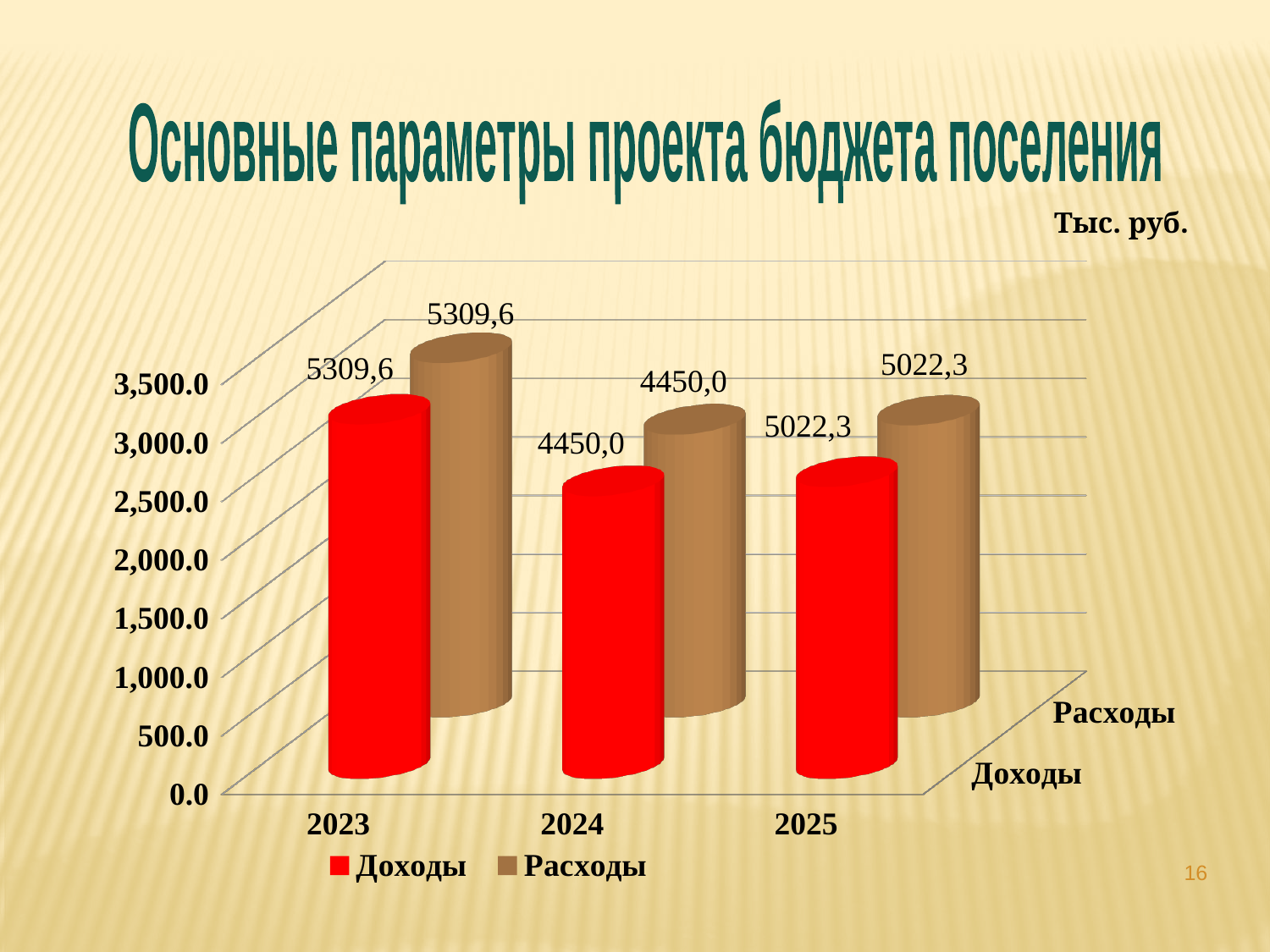
How many years are shown on the x axis of the chart? 3 What kind of chart is shown on the slide? Bar chart Which is larger: Доходы in 2025 or Доходы in 2024? Доходы in 2025 Which year has the highest value of Доходы? 2023 What is the value of Расходы for 2024? 4450,0 Which year has the lowest value of Расходы? 2024 What is the value of Расходы for 2025? 5022,3 What is the difference between Доходы in 2023 and Доходы in 2024? 859,6 What is the value of Доходы for 2023? 5309,6 What is the value of Доходы for 2025? 5022,3 What is the difference between Расходы in 2025 and Расходы in 2024? 572,3 How many series does the legend list? 2